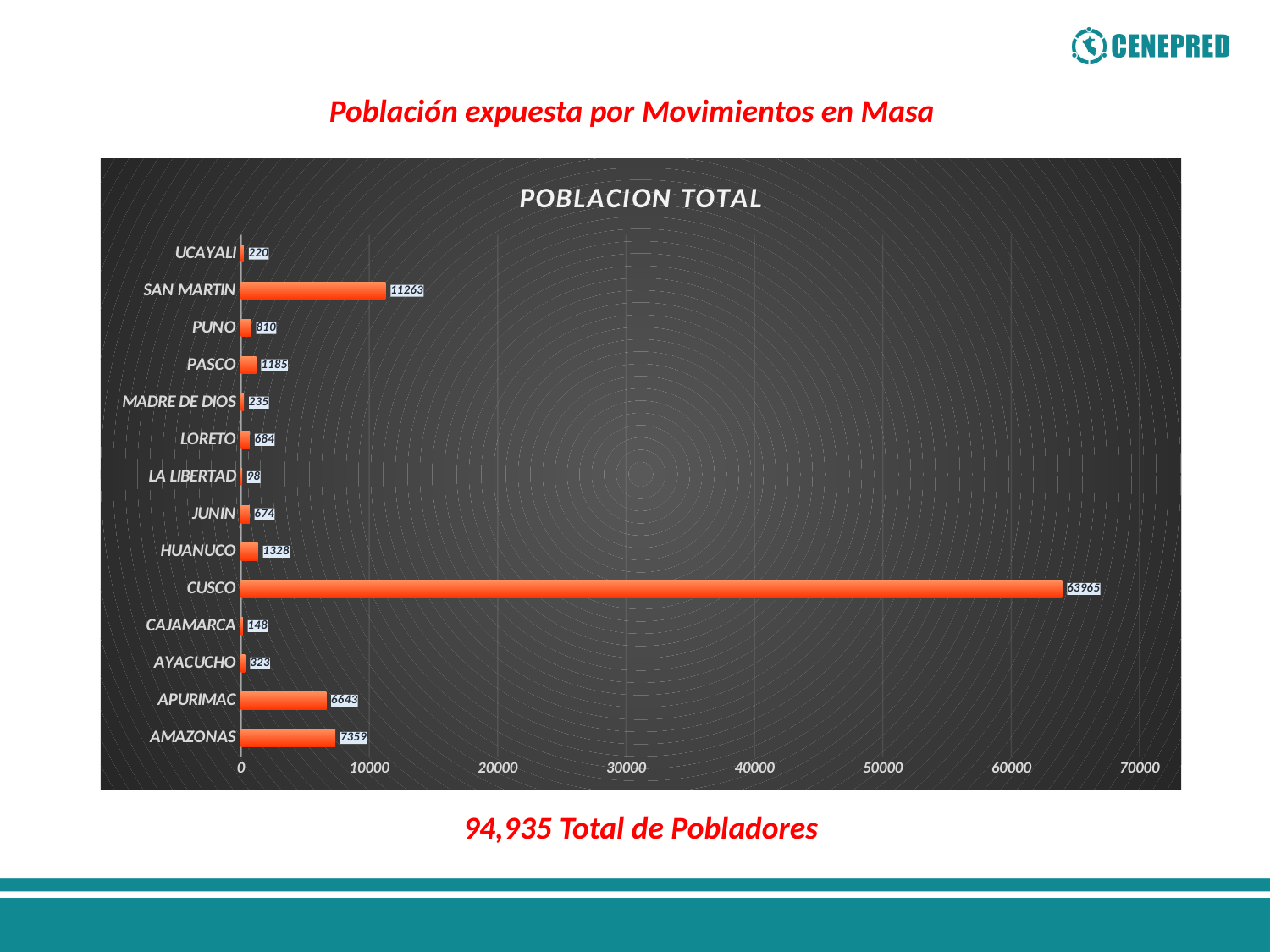
What kind of chart is shown? bar chart How many regions are shown in the chart? 14 What is the difference between the values for AMAZONAS and APURIMAC? 716 Which region has the highest value? CUSCO Which region has the lowest value? LA LIBERTAD Which is larger, the value for PASCO or the value for HUANUCO? HUANUCO What is the value for LA LIBERTAD? 98 What is the value for SAN MARTIN? 11263 What is the value for AMAZONAS? 7359 Is the value for CUSCO greater or less than 60000? greater What is the value for CUSCO? 63965 What is the title of the chart? POBLACION TOTAL